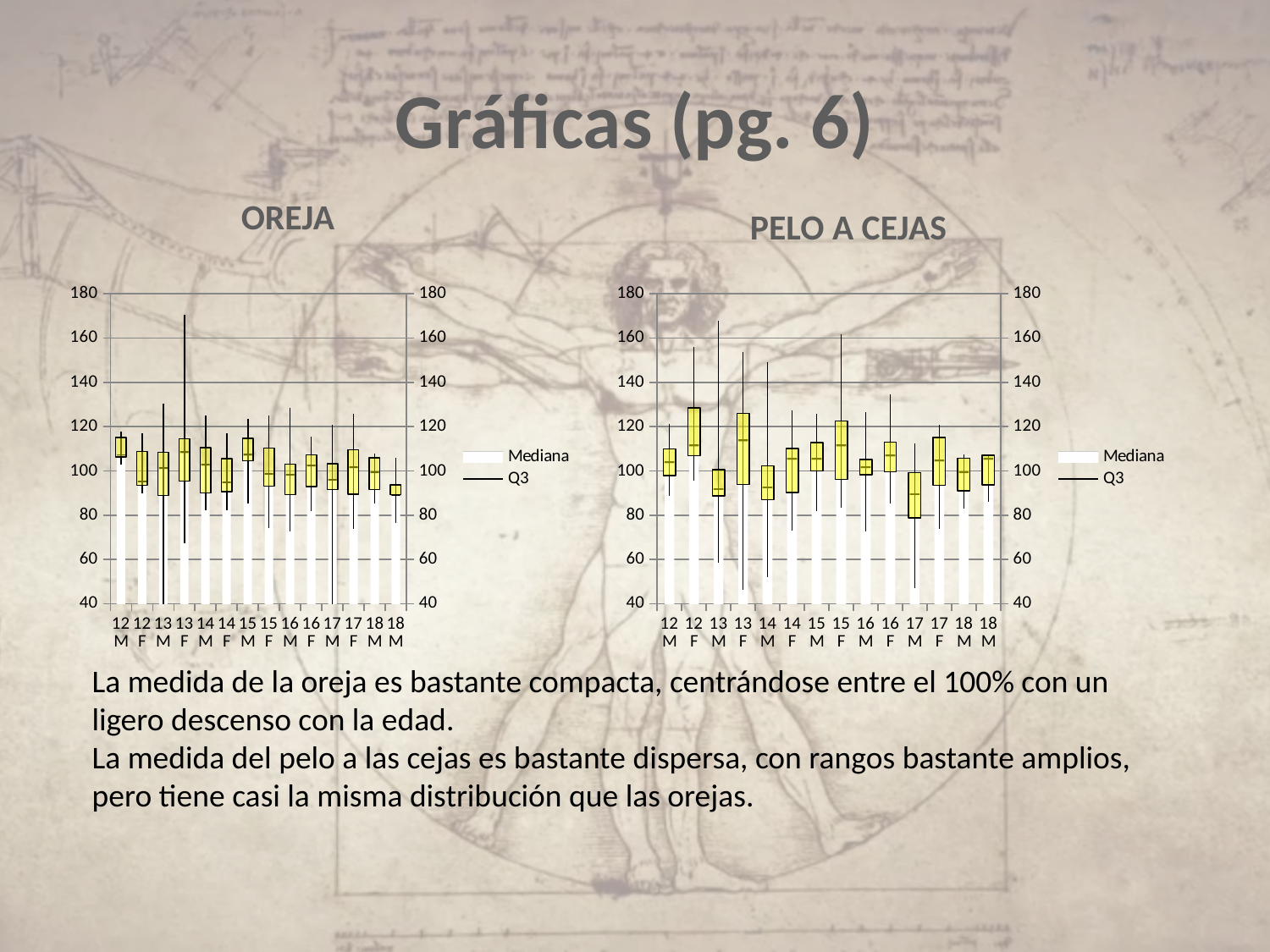
In the OREJA chart, is the top of the upper whisker for 13 F greater or less than 160? greater In the OREJA chart, what is the maximum value shown on the vertical axis? 180 In the PELO A CEJAS chart, is the bottom of the box for 17 M greater or less than 100? less In the PELO A CEJAS chart, is the top of the box for 12 F greater or less than 120? greater What kind of chart is the PELO A CEJAS chart? box plot What is the title of the chart on the left? OREJA What is the title of the chart on the right? PELO A CEJAS In the OREJA chart, how many entries does the legend list? 2 In the OREJA chart, how many categories are plotted along the x axis? 14 In the PELO A CEJAS chart, how many age/sex categories are shown on the x axis? 14